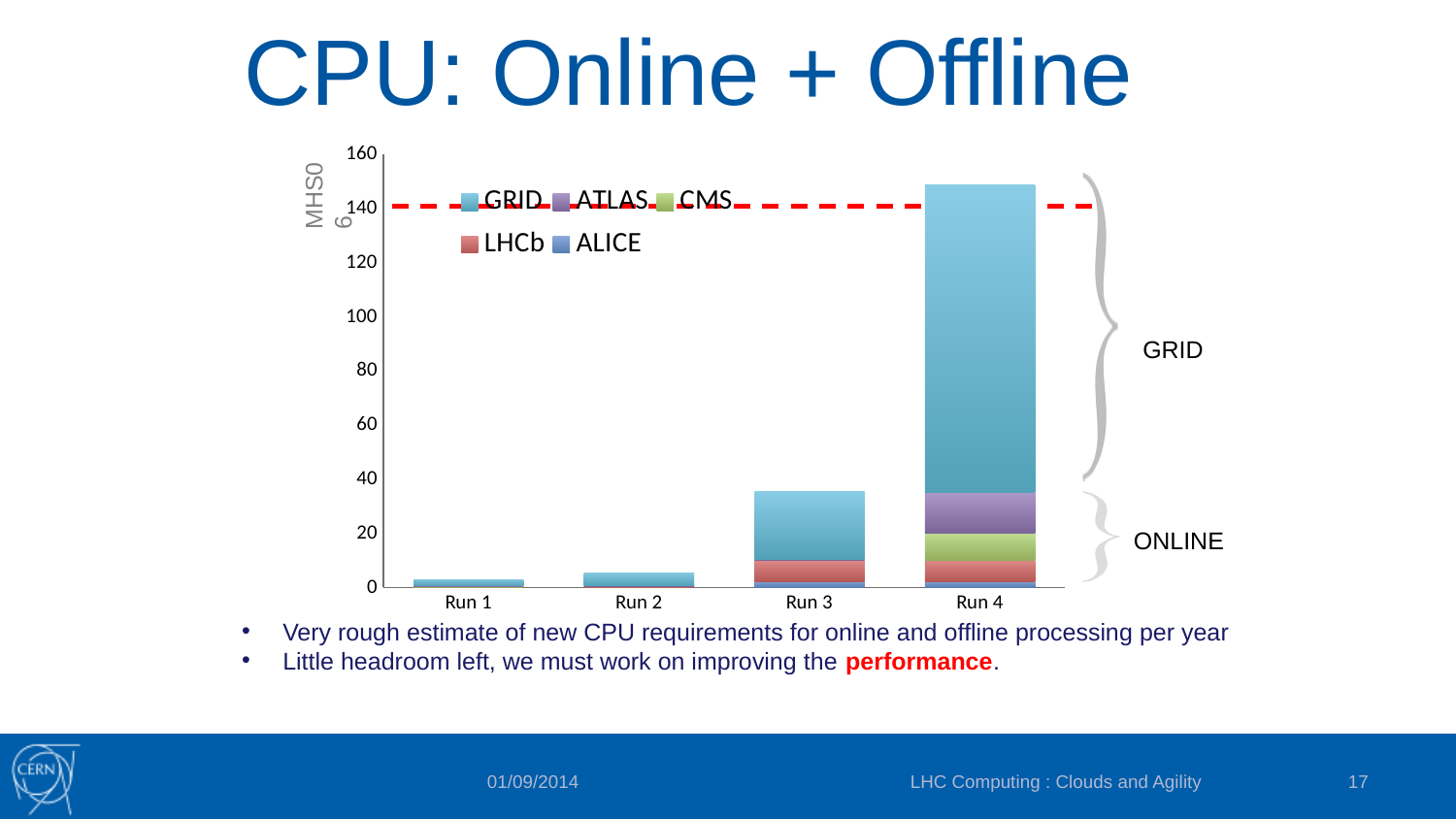
What kind of chart is shown on the slide? Stacked bar chart What is the label on the y axis of the chart? MHS06 Is the total value for Run 2 greater or less than 20? less How many categories (runs) are shown on the x axis? 4 Do the total CPU requirements rise or fall from Run 1 to Run 4? Rise Which run has the lowest total CPU requirement? Run 1 How many series does the legend list? 5 Is the total value for Run 3 greater or less than 40? less Is the total value for Run 3 greater or less than 20? greater Which is larger, the total for Run 3 or the total for Run 4? Run 4 Which run has the highest total CPU requirement? Run 4